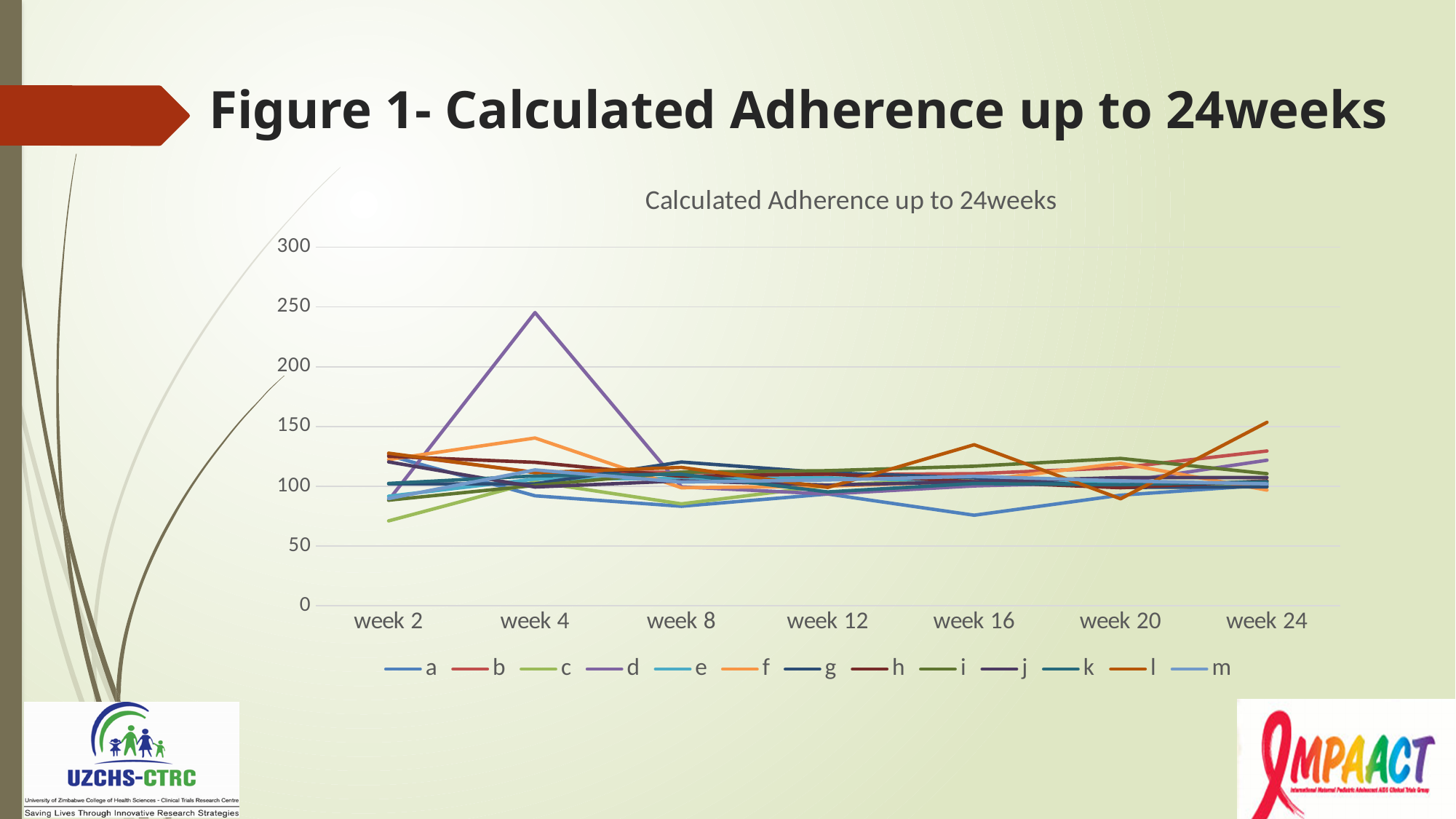
What is the title of the chart? Calculated Adherence up to 24weeks Is the value for series l at week 16 greater or less than 100? greater Does series d rise or fall between week 4 and week 8? fall What kind of chart is shown on the slide? line chart Is the value for series a at week 16 greater or less than 100? less At week 4, which series has the larger value, d or f? d At which week does series d reach its peak? week 4 How many series does the legend list? 13 How many week categories are shown on the x axis? 7 Is the value for series c at week 2 greater or less than 100? less Which series reaches the highest value anywhere on the chart? d